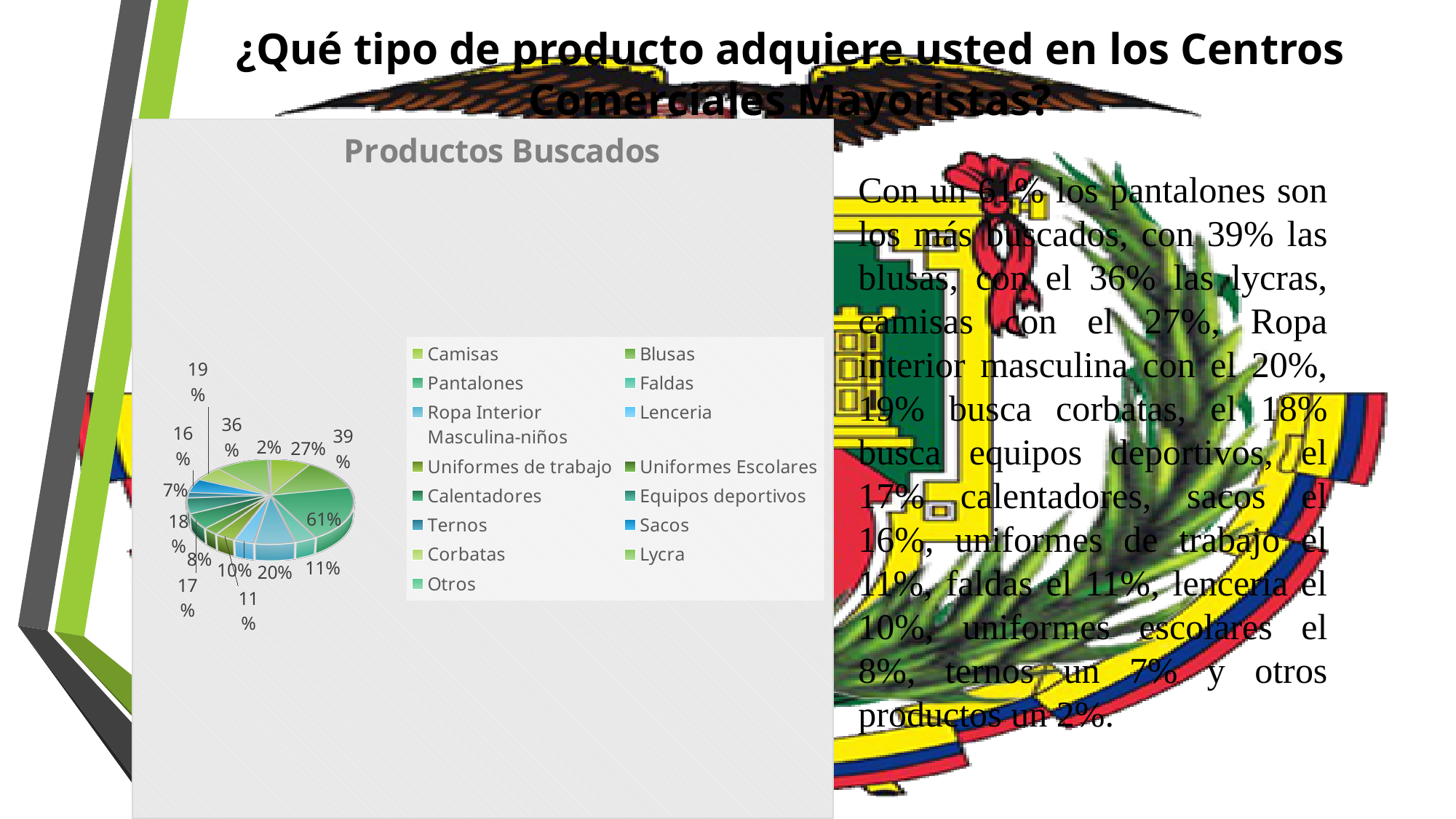
Which category has the smallest slice in the pie chart? Otros How many categories does the chart's legend list? 15 What is the value shown for Ternos? 7% What is the title of the chart? Productos Buscados What is the value shown for Otros? 2% What is the difference between the values for Pantalones and Blusas? 22 percentage points What kind of chart is shown on the slide? Pie chart What is the value shown for Pantalones? 61% What is the value shown for Camisas? 27% Which is larger, the value for Lycra or the value for Camisas? Lycra Which category has the largest slice in the pie chart? Pantalones What is the value shown for Blusas? 39%